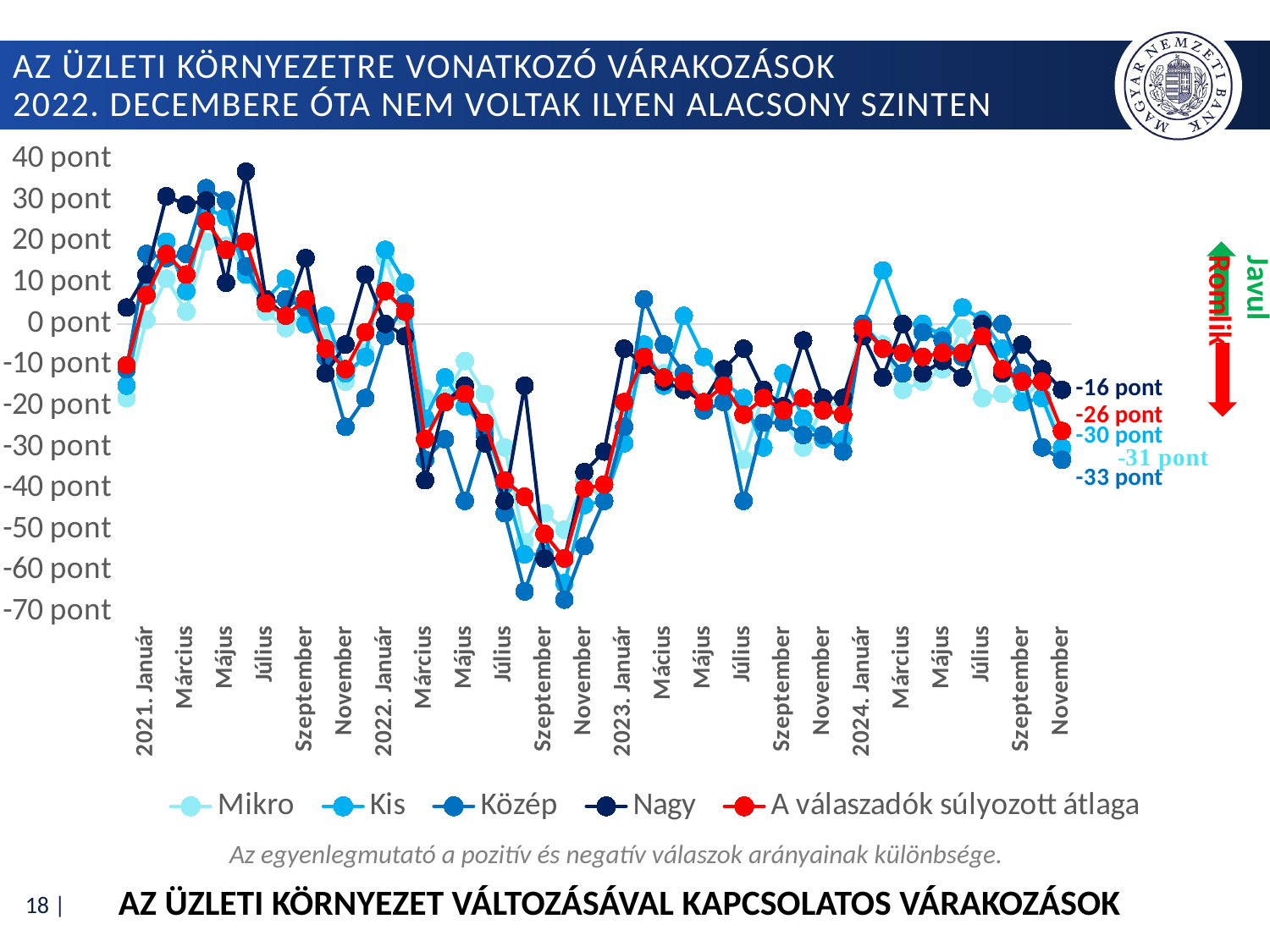
Is the value of the red weighted-average line in September 2022 greater or less than -40 pont? less What kind of chart is shown on the slide? line chart Which series has the lowest labelled value at the end of the chart? Közép What is the difference between the final labelled values of Nagy (-16 pont) and Közép (-33 pont)? 17 pont How many series does the legend list? 5 At the end of the series, which is higher: Kis (-30 pont) or Mikro (-31 pont)? Kis Which legend entry is drawn in red? A válaszadók súlyozott átlaga What is the final value labelled for 'A válaszadók súlyozott átlaga' (the red line)? -26 pont What is the final value labelled for the Kis series? -30 pont Which series has the highest labelled value at the end of the chart? Nagy What is the final (November 2024) value labelled for the Nagy series? -16 pont What is the final value labelled for the Közép series? -33 pont